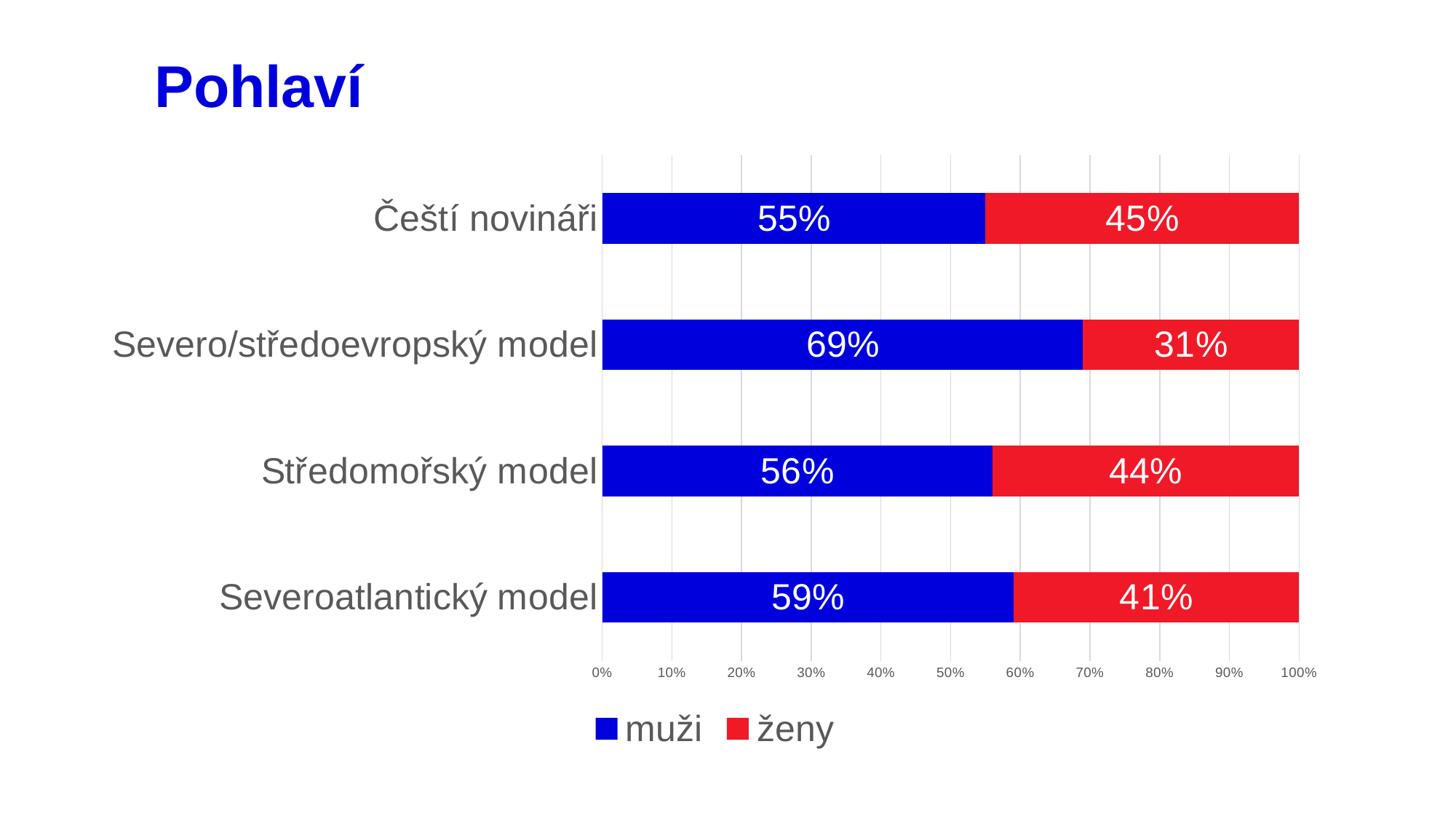
What is the value for ženy in the Severoatlantický model category? 41% Which is larger: the muži value for Severoatlantický model or the muži value for Čeští novináři? Severoatlantický model How many series does the legend list? 2 Which category has the highest value for muži? Severo/středoevropský model What kind of chart is shown on the slide? Stacked bar chart What is the total of the stacked bar for Středomořský model? 100% What is the difference between the muži and ženy values for Severo/středoevropský model? 38% Which category has the lowest value for ženy? Severo/středoevropský model What is the value for muži in the Čeští novináři category? 55% How many categories are shown on the chart? 4 What is the value for ženy in the Severo/středoevropský model category? 31% What is the value for muži in the Středomořský model category? 56%